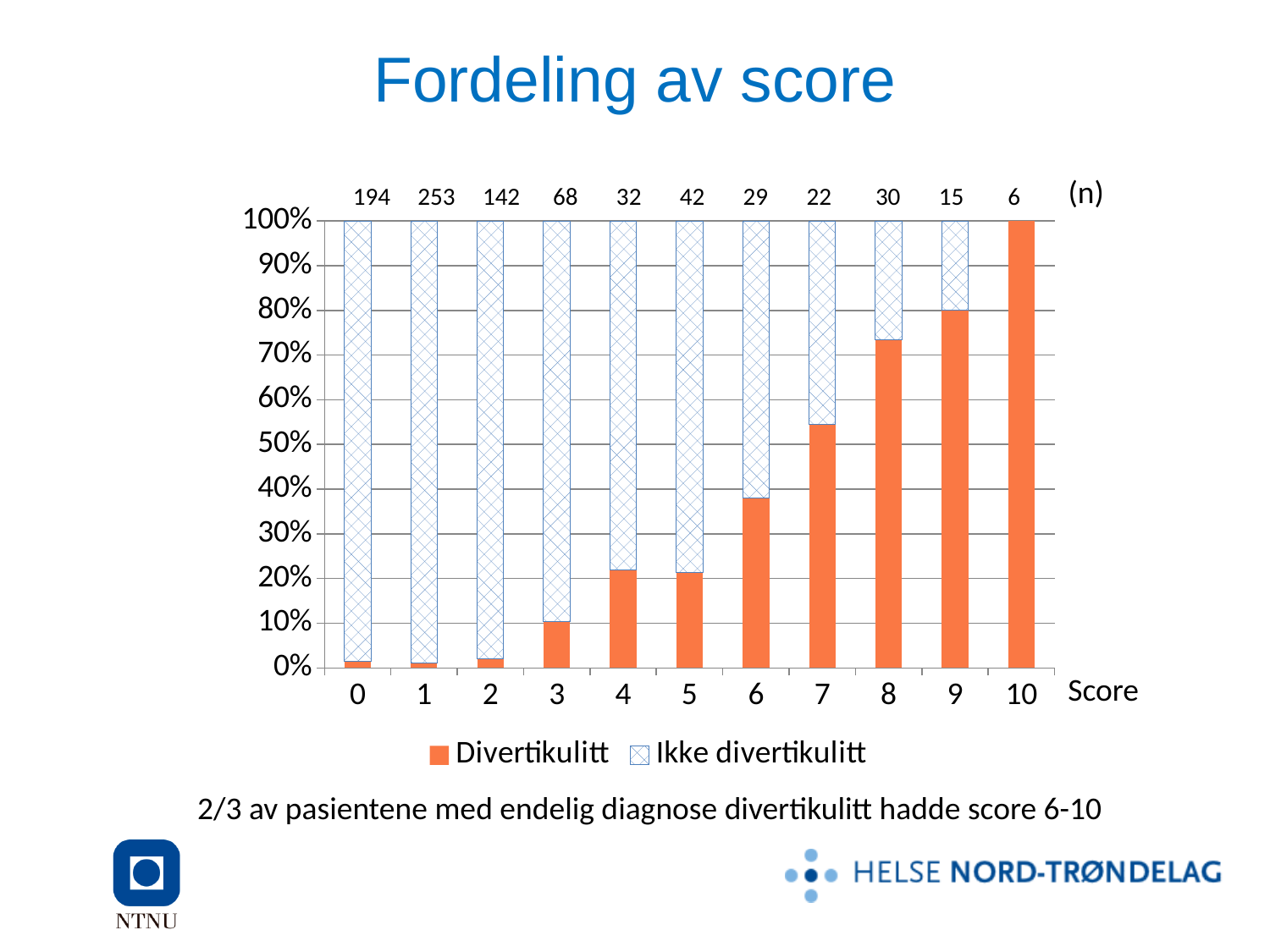
What is the n value printed above the bar for score 1? 253 Which score has the lowest n value printed above its bar? 10 How many score categories are shown on the x axis? 11 Which score has the highest n value printed above its bar? 1 What is the difference between the n values for score 1 and score 0? 59 Does the Divertikulitt share rise or fall as the score increases from 0 to 10? rise What is the Divertikulitt share for score 10? 100% Is the Divertikulitt share for score 8 greater or less than 70%? greater What is the n value printed above the bar for score 4? 32 How many series does the legend list? 2 Is the Divertikulitt share for score 6 greater or less than 40%? less What kind of chart is shown on the slide? bar chart